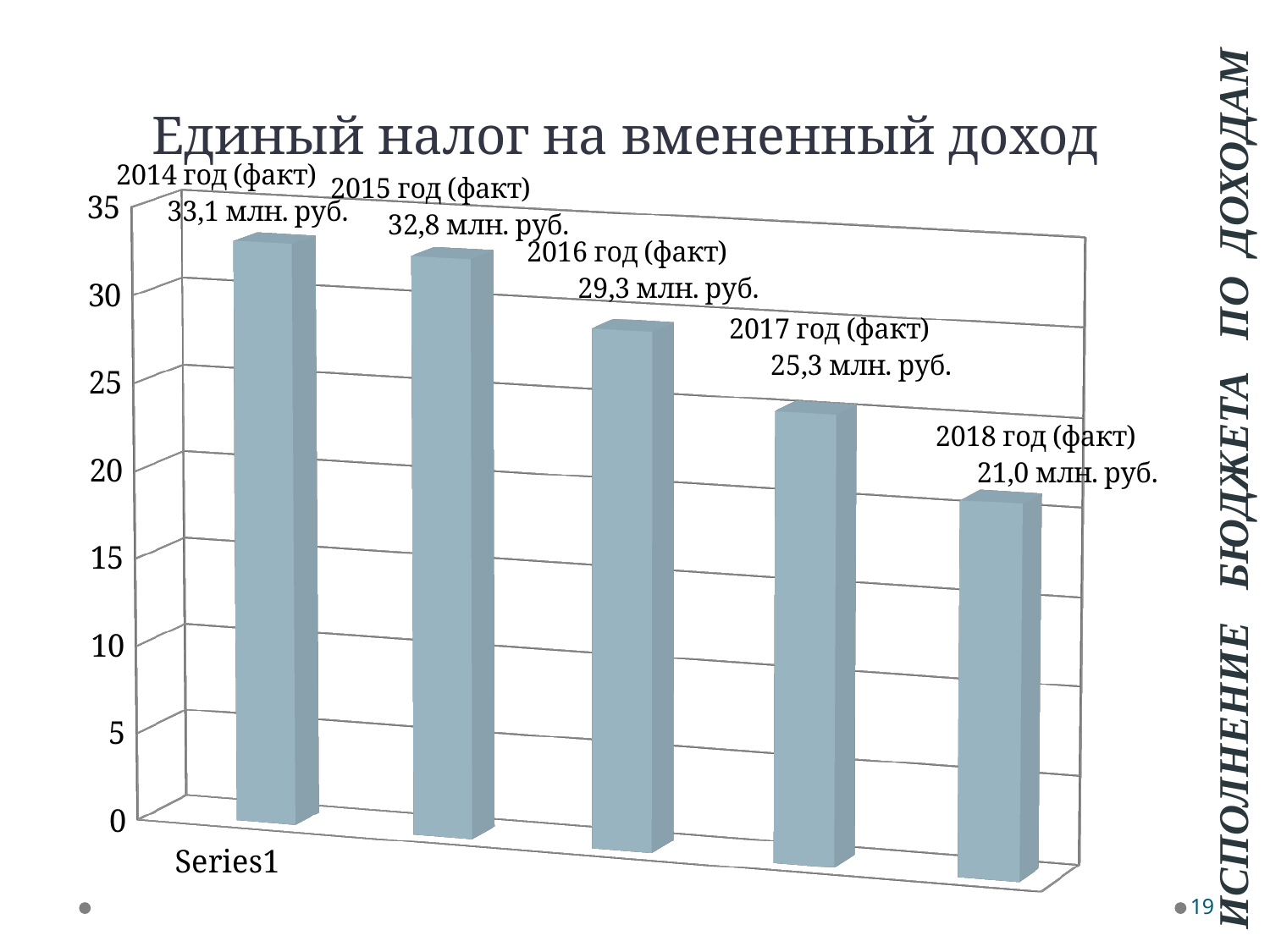
Which year has the lowest value? 2018 год (факт) What is the difference between the values for 2014 год (факт) and 2018 год (факт)? 12,1 млн. руб. What is the difference between the values for 2016 год (факт) and 2017 год (факт)? 4,0 млн. руб. Which year has the highest value? 2014 год (факт) How many bars are shown in the chart? 5 Do the values rise or fall from 2014 to 2018? fall What kind of chart is shown on the slide? bar chart Is the value for 2016 год (факт) greater or less than 25? greater What is the value for 2018 год (факт)? 21,0 млн. руб. Which is larger, the value for 2015 год (факт) or 2016 год (факт)? 2015 год (факт) What is the value for 2017 год (факт)? 25,3 млн. руб. What is the value for 2014 год (факт)? 33,1 млн. руб.